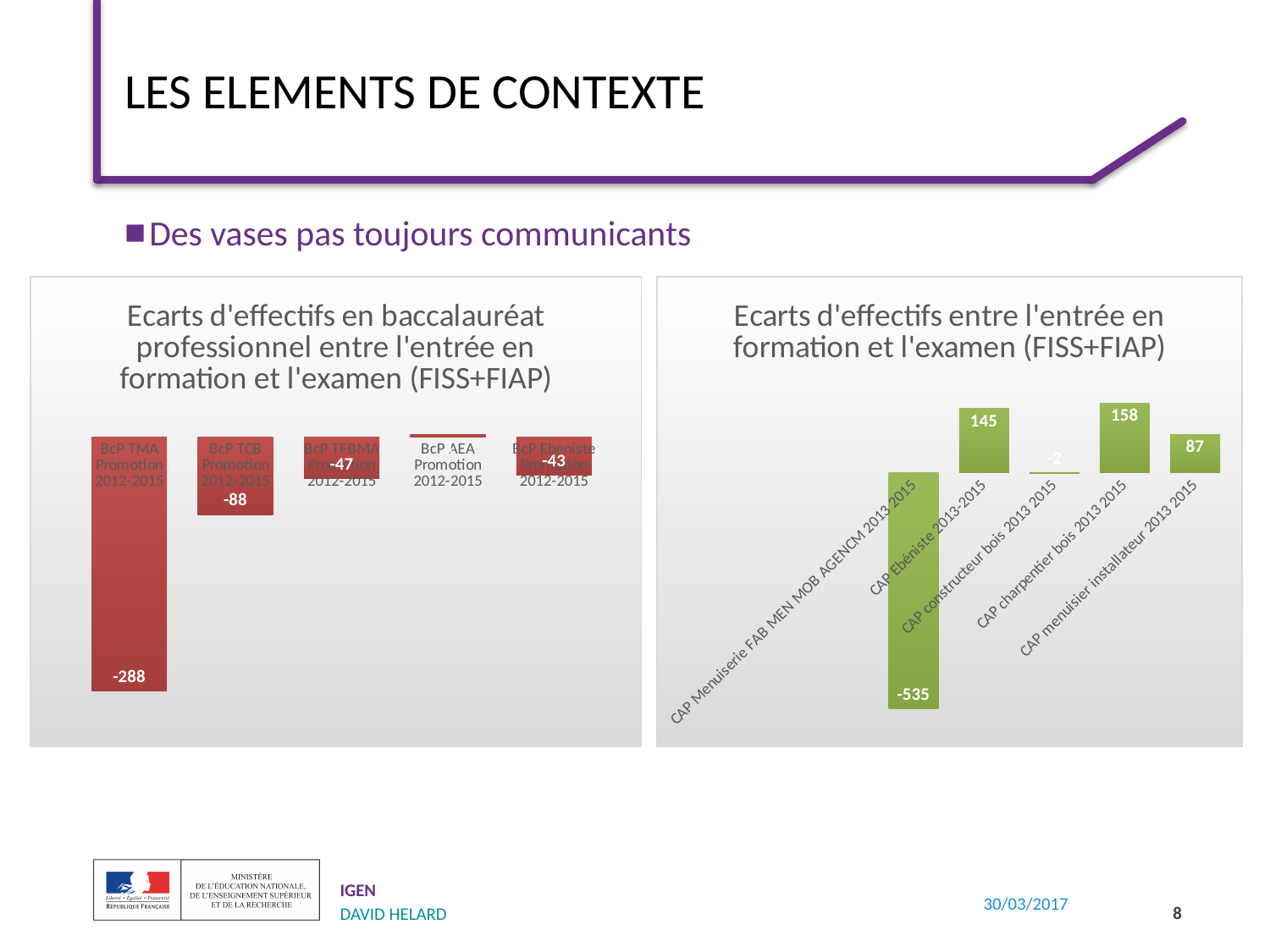
In the right chart (CAP), what is the difference between the values for CAP charpentier bois and CAP Ebéniste? 13 In the right chart (CAP), which is larger, the value for CAP Ebéniste 2013-2015 or CAP menuisier installateur 2013 2015? CAP Ebéniste 2013-2015 In the left chart (baccalauréat professionnel), which category has the lowest value? BcP TMA Promotion 2012-2015 In the left chart (baccalauréat professionnel), what is the value for BcP TMA Promotion 2012-2015? -288 In the right chart (CAP), which category has the highest value? CAP charpentier bois 2013 2015 What type of chart is the right chart (CAP)? Bar chart In the left chart (baccalauréat professionnel), what is the value for BcP Ebeniste Promotion 2012-2015? -43 In the right chart (CAP), what is the value for CAP Menuiserie FAB MEN MOB AGENCM 2013 2015? -535 In the left chart (baccalauréat professionnel), how many categories are shown? 5 In the right chart (CAP), what is the value for CAP charpentier bois 2013 2015? 158 In the left chart (baccalauréat professionnel), what is the value for BcP TCB Promotion 2012-2015? -88 In the left chart (baccalauréat professionnel), what is the difference between the values for BcP TCB and BcP TFBMA? 41